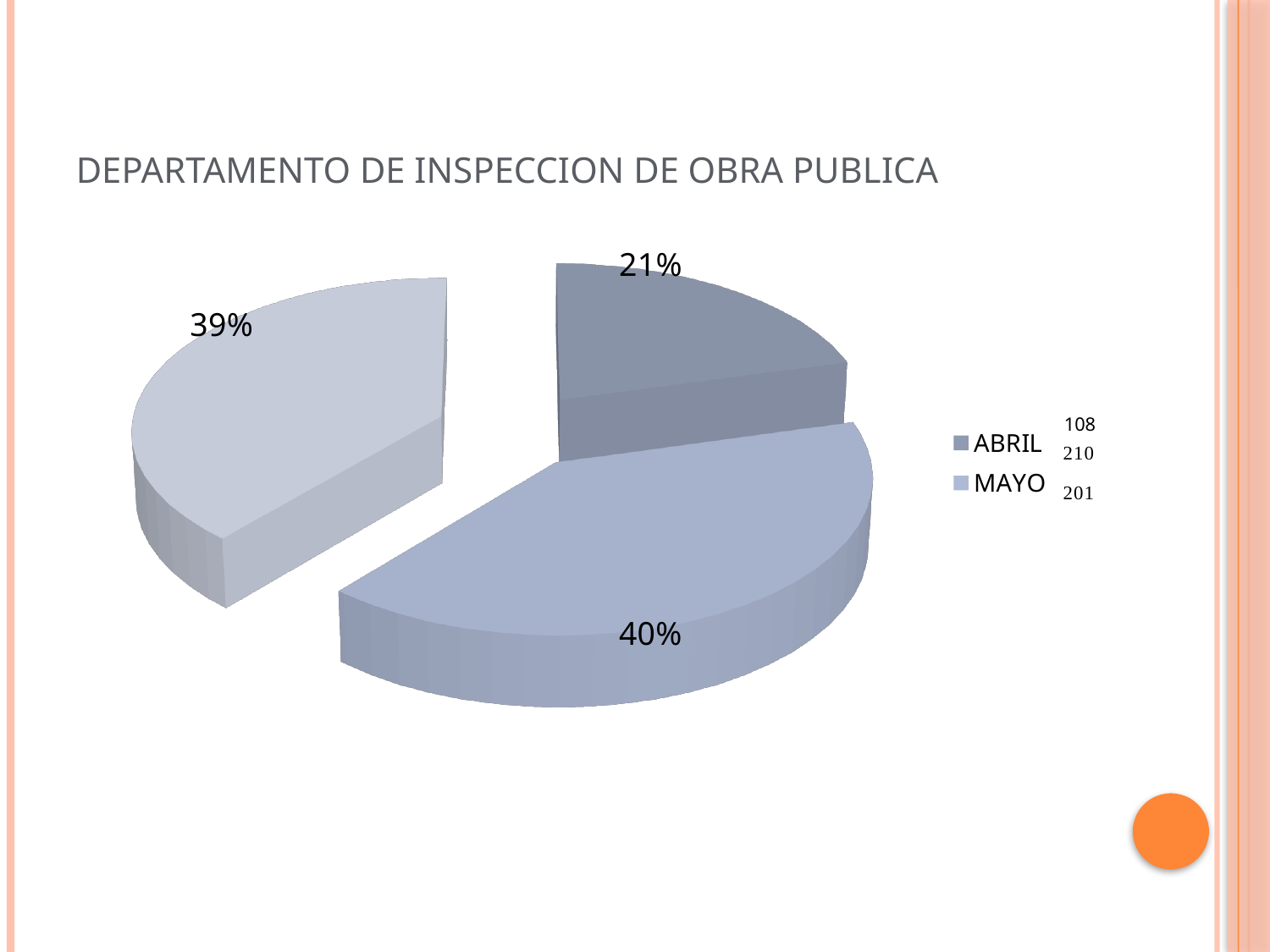
Which legend entry is listed first? ABRIL What is the smallest percentage label shown on the pie chart? 21% How many slices does the pie chart have? 3 What is the difference in percentage points between the MAYO slice and the ABRIL slice? 19 What percentage is shown for the MAYO slice? 40% How many entries does the legend list? 2 Which slice is larger, ABRIL or MAYO? MAYO What kind of chart is shown on the slide? pie chart What is the title of the chart? DEPARTAMENTO DE INSPECCION DE OBRA PUBLICA What is the largest percentage label shown on the pie chart? 40% What percentage is shown for the ABRIL slice? 21%